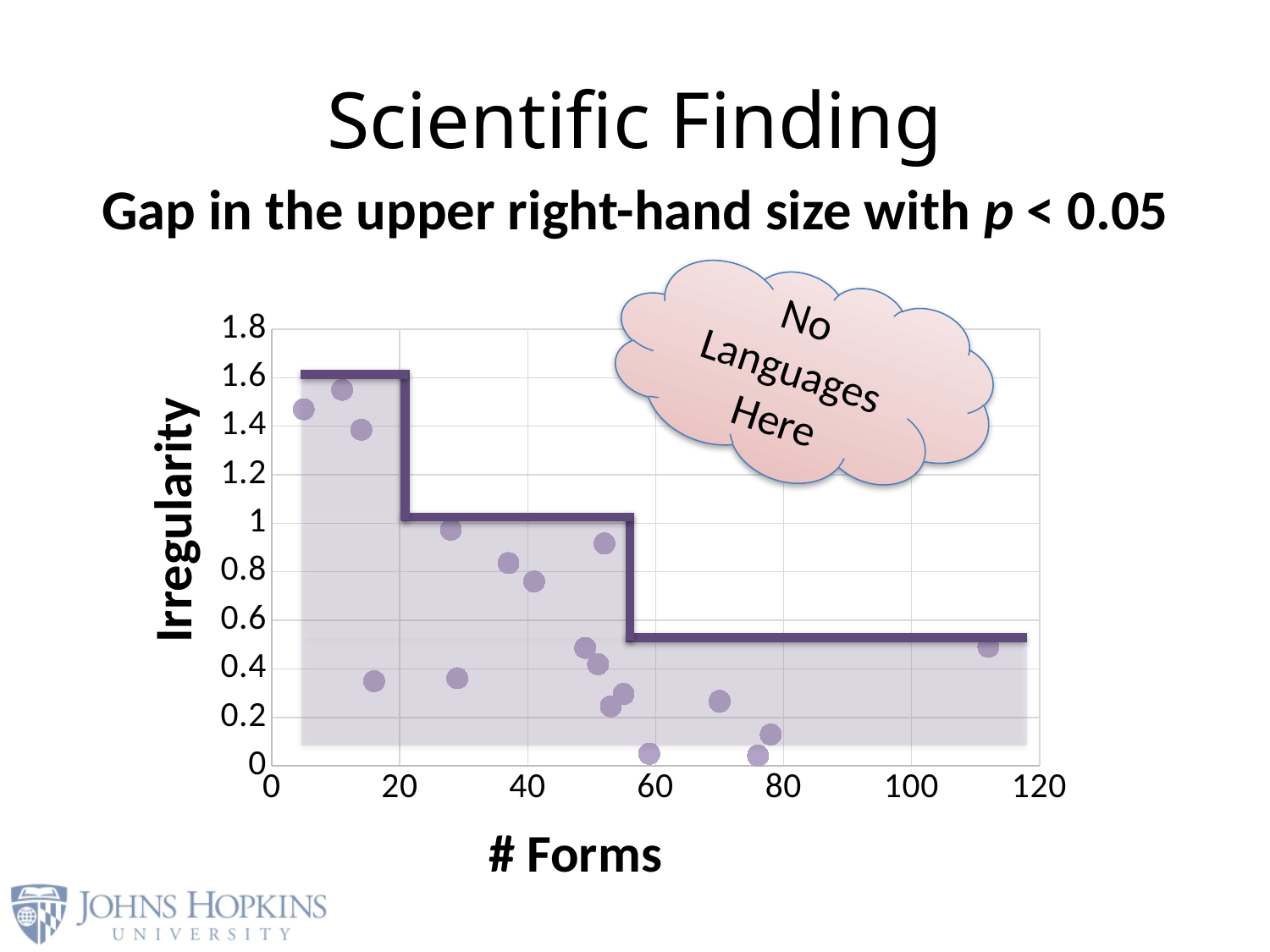
Is the irregularity of the point plotted at about 112 forms greater or less than 1? less Is the irregularity of the highest point on the chart greater or less than 1.4? greater What is the highest value shown on the x axis of the chart? 120 Is the irregularity of the point plotted at about 70 forms greater or less than 0.6? less What is the label of the x axis of the chart? # Forms What is the label of the y axis of the chart? Irregularity What kind of chart is shown on the slide? scatter chart Overall, does irregularity tend to rise or fall as the number of forms increases along the x axis? fall Which has the higher irregularity: the point near 11 forms or the point near 112 forms? the point near 11 forms